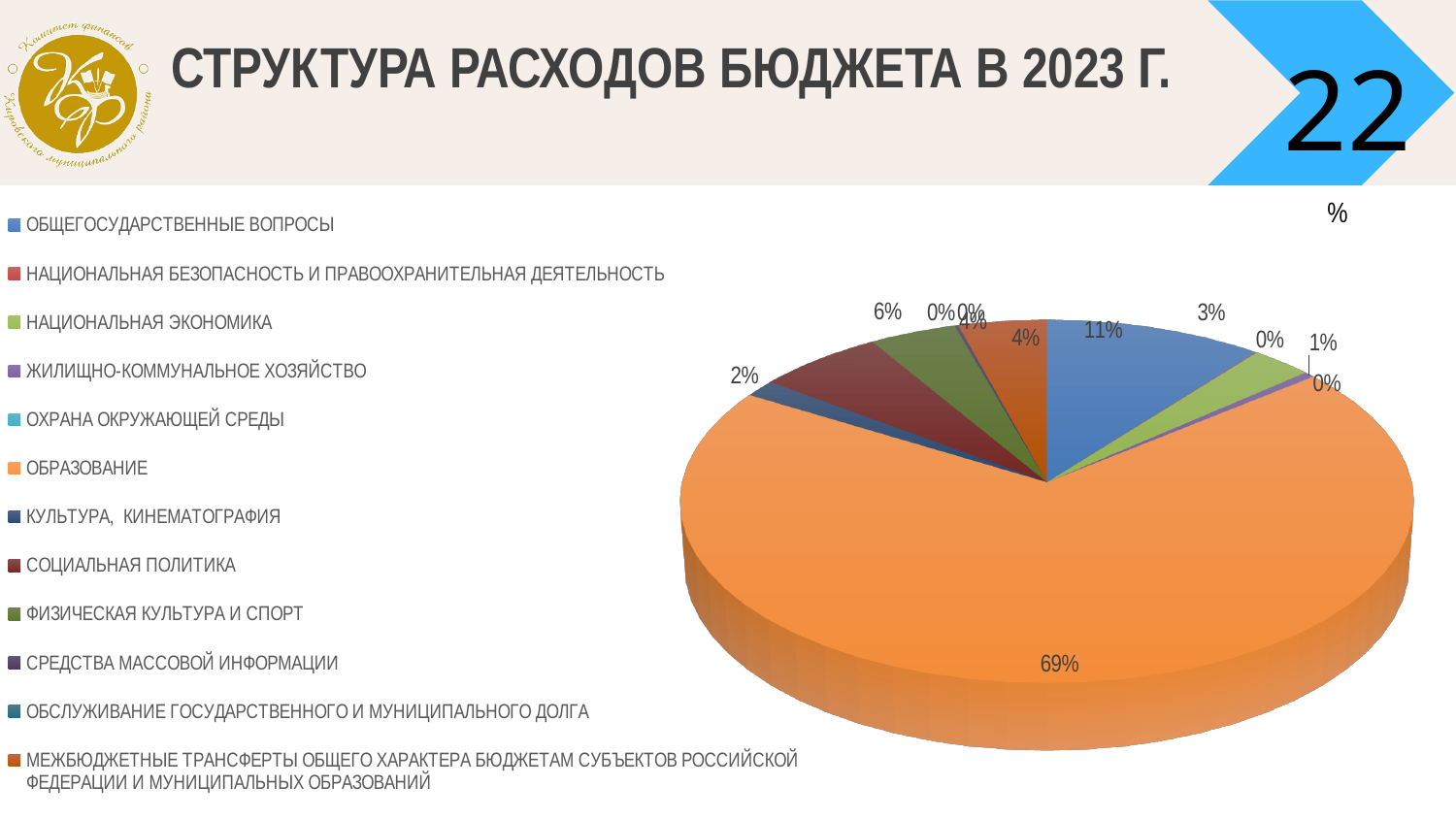
What kind of chart is shown on the slide? pie chart What share of the pie is ОБРАЗОВАНИЕ? 69% What is the value for КУЛЬТУРА, КИНЕМАТОГРАФИЯ? 2% Which is larger, the share for ОБРАЗОВАНИЕ or the share for ОБЩЕГОСУДАРСТВЕННЫЕ ВОПРОСЫ? ОБРАЗОВАНИЕ What is the value for ОБЩЕГОСУДАРСТВЕННЫЕ ВОПРОСЫ? 11% What is the value for СОЦИАЛЬНАЯ ПОЛИТИКА? 6% Which category has the largest share of the pie? ОБРАЗОВАНИЕ What is the value for НАЦИОНАЛЬНАЯ ЭКОНОМИКА? 3% What is the difference in percentage points between ОБРАЗОВАНИЕ and ОБЩЕГОСУДАРСТВЕННЫЕ ВОПРОСЫ? 58 How many categories does the legend list? 12 What is the difference in percentage points between ОБЩЕГОСУДАРСТВЕННЫЕ ВОПРОСЫ and СОЦИАЛЬНАЯ ПОЛИТИКА? 5 What is the title of the chart? СТРУКТУРА РАСХОДОВ БЮДЖЕТА В 2023 Г.